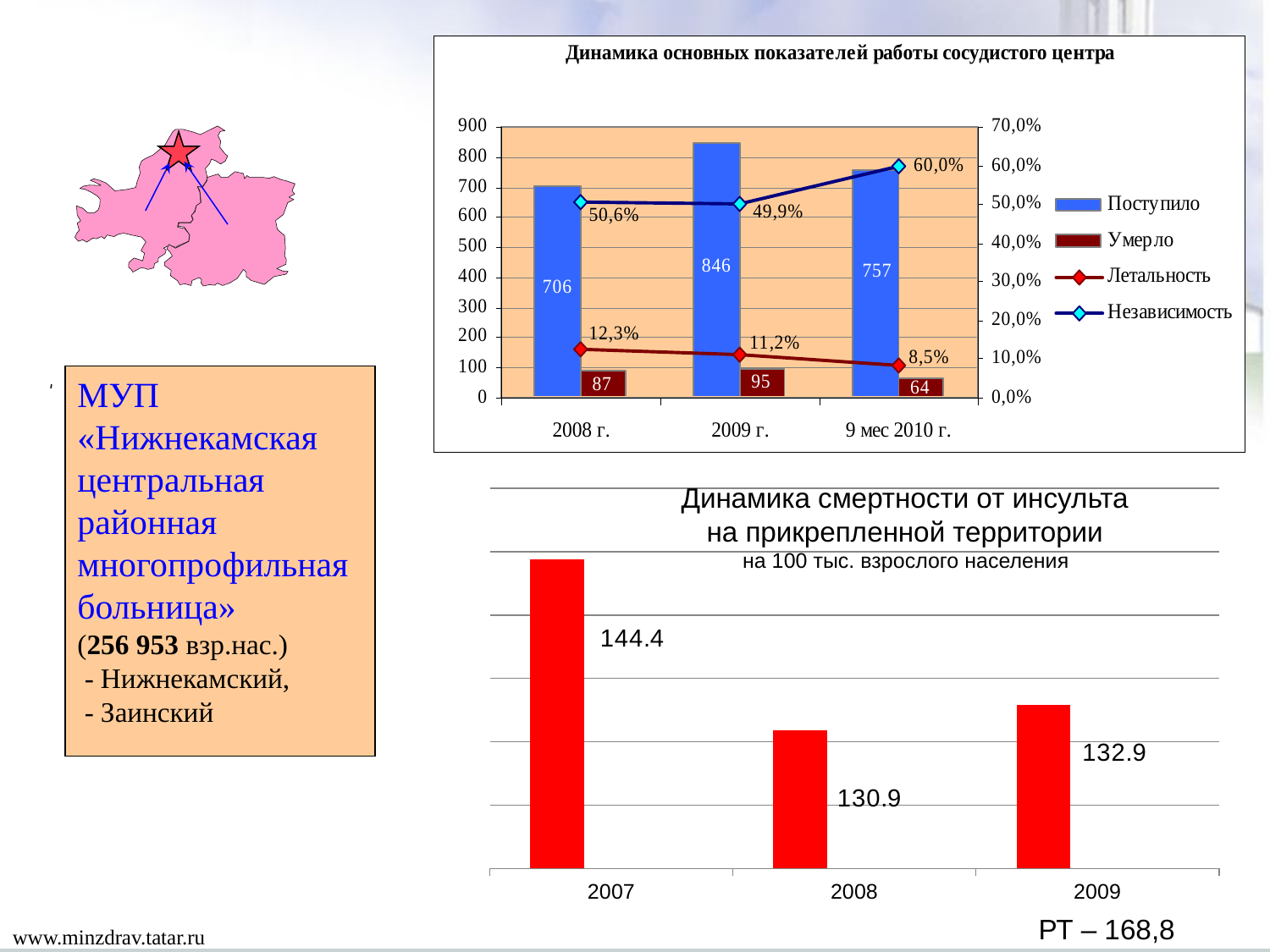
What kind of chart is 'Динамика смертности от инсульта на прикрепленной территории'? bar chart In the chart 'Динамика основных показателей работы сосудистого центра', what is the Независимость value for 9 мес 2010 г.? 60,0% How many series does the legend of the chart 'Динамика основных показателей работы сосудистого центра' list? 4 In the chart 'Динамика основных показателей работы сосудистого центра', what is the value of Умерло for 9 мес 2010 г.? 64 In the chart 'Динамика основных показателей работы сосудистого центра', what is the value of Поступило for 2009 г.? 846 In the chart 'Динамика основных показателей работы сосудистого центра', what is the difference between Поступило in 2009 г. and 2008 г.? 140 In the chart 'Динамика основных показателей работы сосудистого центра', what is the Летальность value for 2008 г.? 12,3% In the chart 'Динамика основных показателей работы сосудистого центра', does Летальность rise or fall from 2008 г. to 9 мес 2010 г.? fall In the chart 'Динамика смертности от инсульта на прикрепленной территории', what is the value for 2008? 130.9 In the chart 'Динамика основных показателей работы сосудистого центра', which period has the highest Поступило value? 2009 г. In the chart 'Динамика смертности от инсульта на прикрепленной территории', which year has the highest value? 2007 In the chart 'Динамика основных показателей работы сосудистого центра', which period has the lowest Умерло value? 9 мес 2010 г.